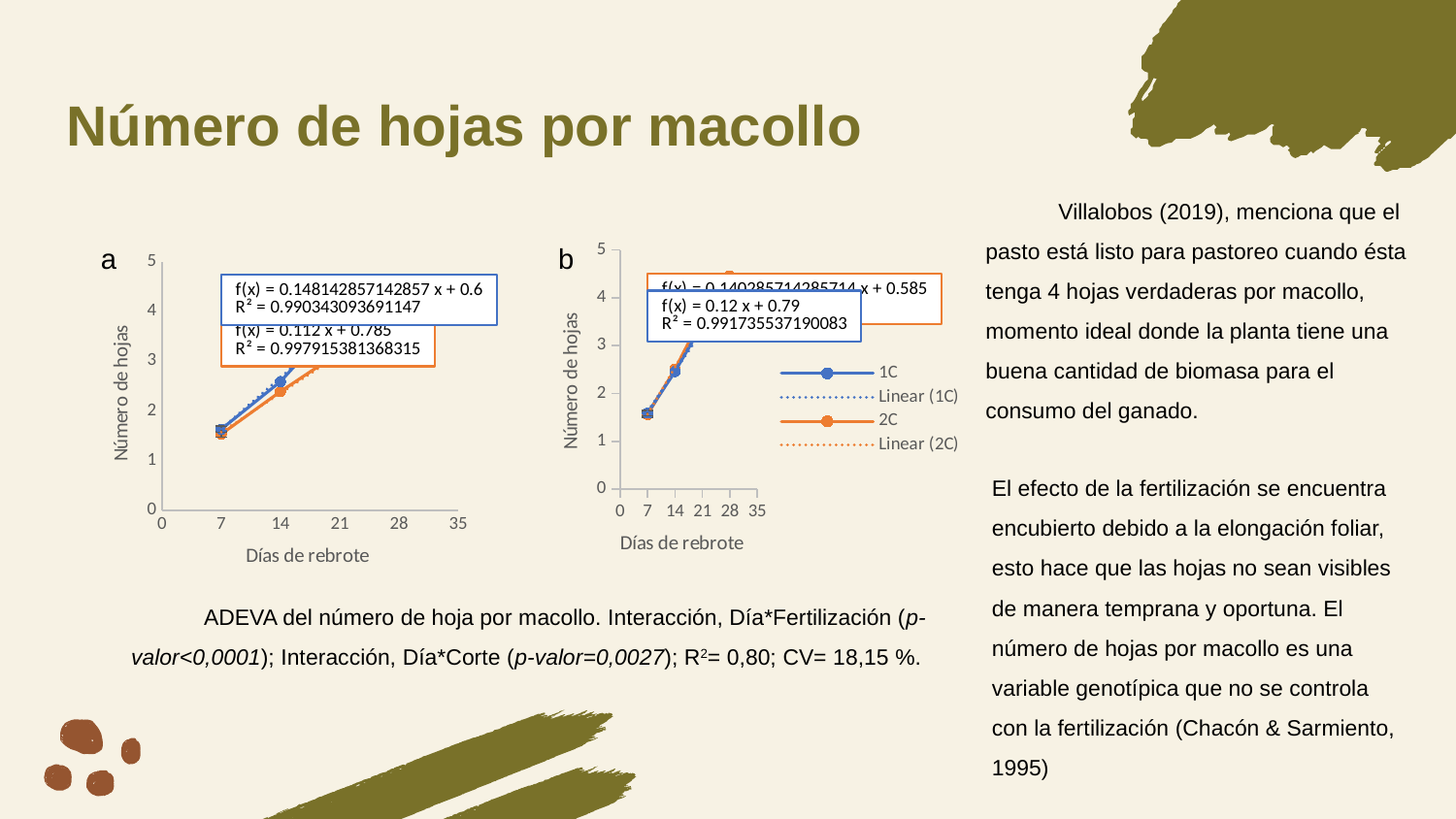
In chart a on the left, what is the R² value shown for the trendline f(x) = 0.112 x + 0.785? 0.997915381368315 In chart b on the right, do the values rise or fall along the x axis? rise In chart b on the right, is the value for 1C at 14 days greater or less than 2? greater In chart b on the right, what are the legend entries? 1C, Linear (1C), 2C, Linear (2C) In chart b on the right, how many entries does the legend list? 4 What kind of chart is chart a on the left? line chart In chart a on the left, is the value at 7 days greater or less than 2? less What is the x-axis title of chart a on the left? Días de rebrote In chart b on the right, what is the R² value shown for the trendline f(x) = 0.12 x + 0.79? 0.991735537190083 In chart a on the left, do the values rise or fall as the days of regrowth increase? rise In chart a on the left, is the value at 14 days greater or less than 2? greater